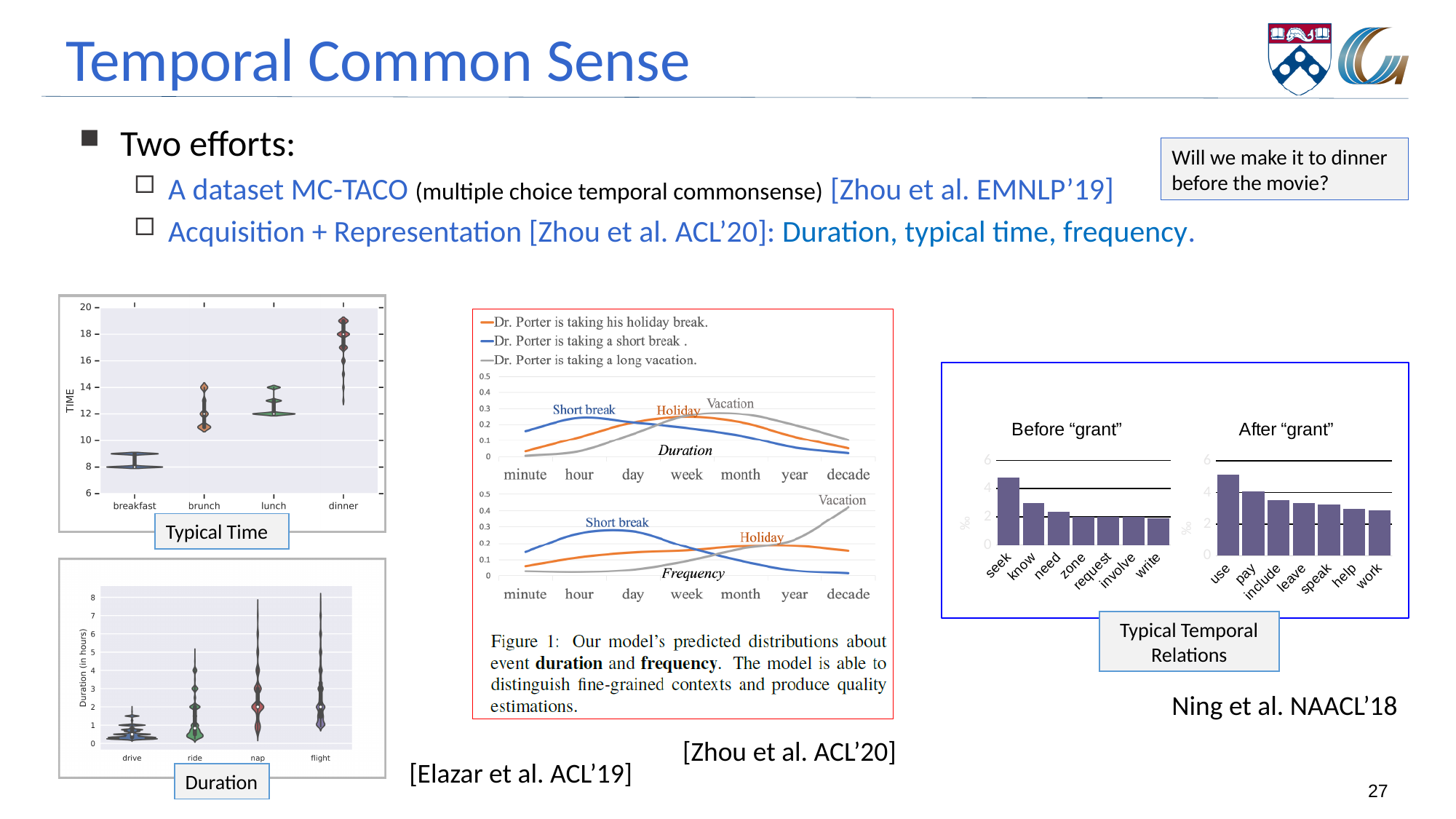
In the "Before "grant"" chart, which word has the highest bar? seek In the "After "grant"" chart, do the bar values rise or fall from use to work? fall In the "Typical Time" chart, which category has the highest time values? dinner What kind of chart is the "Before "grant"" chart? bar chart In the "Typical Time" chart, which category has the lowest time values? breakfast In the middle figure (Zhou et al. ACL'20), how many series does the legend list? 3 In the "Typical Time" chart, how many categories are shown on the x axis? 4 In the "Typical Time" chart, is the value for breakfast greater or less than 10? less In the "After "grant"" chart, which word has the highest bar? use In the "Before "grant"" chart, is the value for seek greater or less than 4? greater In the middle figure (Zhou et al. ACL'20), how many points are on the x axis of the Duration plot? 7 In the "Duration" chart, how many categories are shown on the x axis? 4